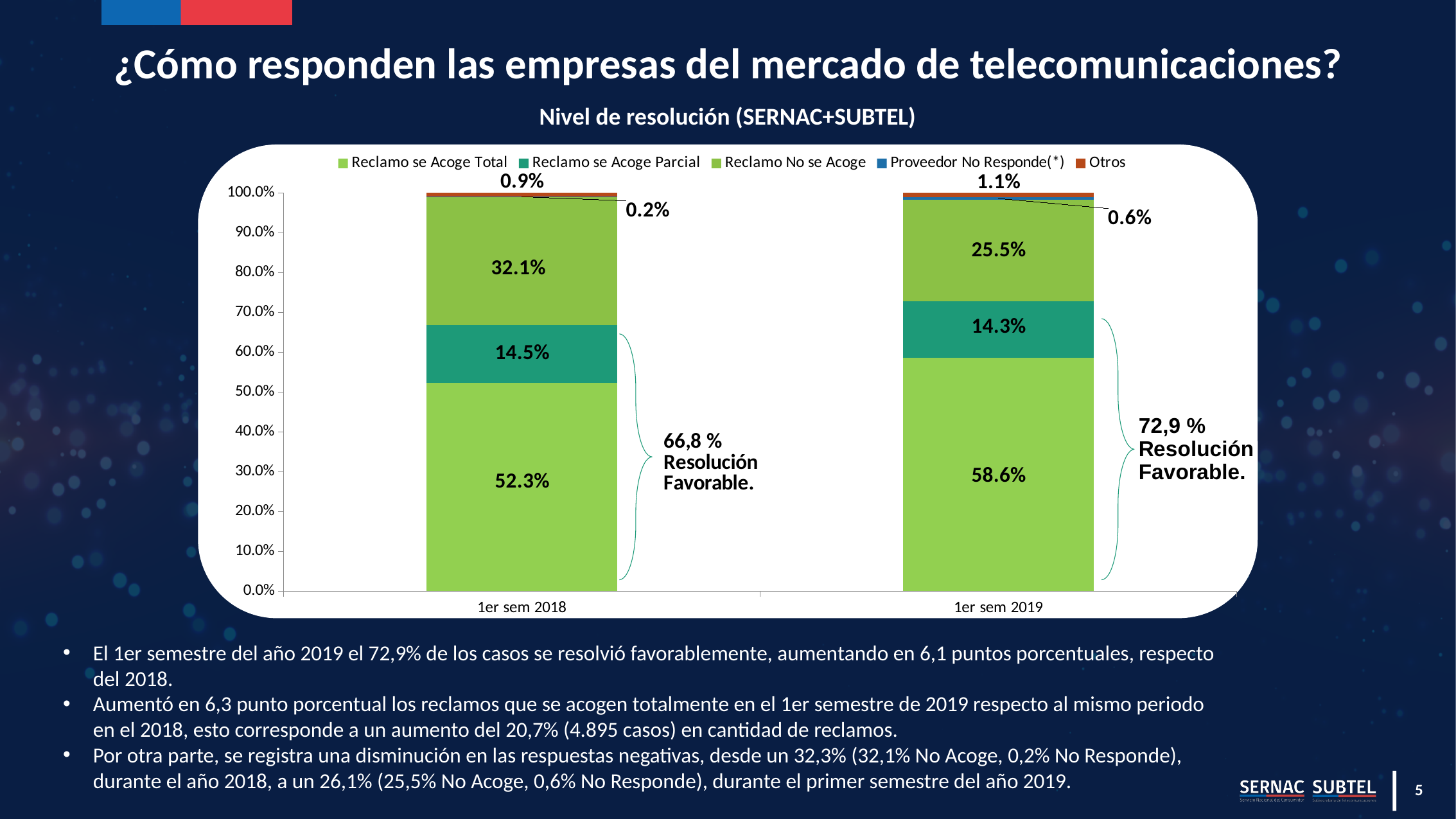
Which period has the larger value for Reclamo se Acoge Total, 1er sem 2018 or 1er sem 2019? 1er sem 2019 What is the value for Reclamo se Acoge Parcial in 1er sem 2018? 14.5% What kind of chart is shown on the slide? Stacked bar chart How many categories are shown on the x axis? 2 What is the value for Reclamo se Acoge Total in 1er sem 2018? 52.3% What is the value for Reclamo No se Acoge in 1er sem 2019? 25.5% What is the title of the chart? Nivel de resolución (SERNAC+SUBTEL) What is the value for Reclamo se Acoge Total in 1er sem 2019? 58.6% What is the difference between the Reclamo No se Acoge values for 1er sem 2018 and 1er sem 2019? 6.6% How many series does the legend list? 5 What is the value for Otros in 1er sem 2018? 0.9% What is the value for Proveedor No Responde(*) in 1er sem 2019? 0.6%